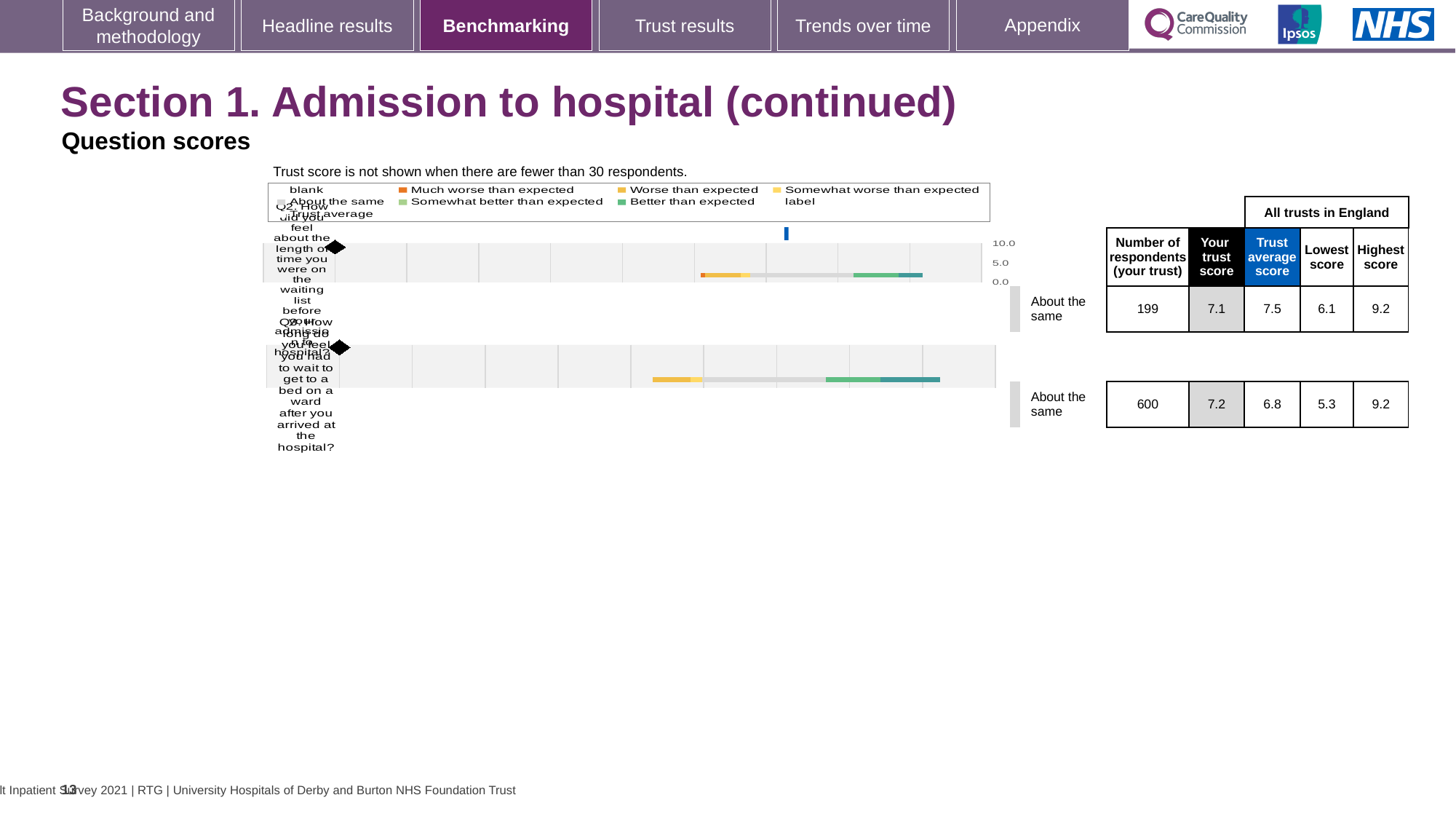
What is the difference between the highest score and the lowest score for Q3? 3.9 What is the number of respondents (your trust) for Q2, about the length of time on the waiting list before admission? 199 For Q2, which is larger: your trust score or the trust average score? Trust average score How many questions are plotted in the chart? 2 What is the trust average score for Q2, about the length of time on the waiting list? 7.5 How many more respondents answered Q3 than Q2? 401 What benchmark category is shown next to the bar for Q2? About the same Which question has more respondents, Q2 or Q3? Q3 What is the highest score across all trusts in England for Q2? 9.2 What is the trust score for Q3, about how long you had to wait to get to a bed on a ward? 7.2 For Q3, which is larger: your trust score or the trust average score? Your trust score What is the lowest score across all trusts in England for Q3, about waiting to get to a bed on a ward? 5.3